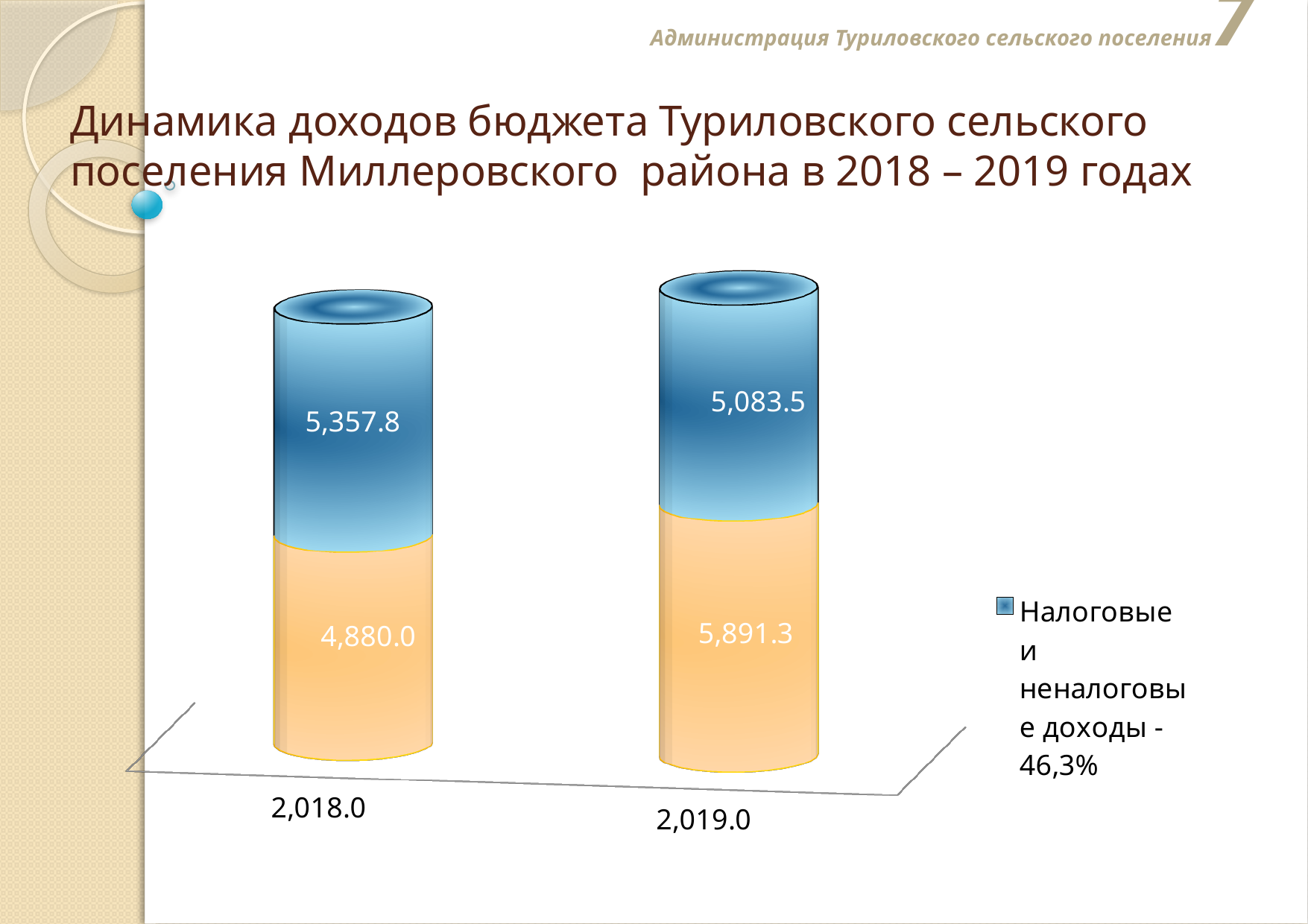
How many categories (years) are shown on the x axis of the chart? 2 What is the value of the lower orange segment of the bar for 2,019.0? 5,891.3 What is the total of the stacked bar for 2,019.0? 10,974.8 What type of chart is shown on the slide? Bar chart What is the total of the stacked bar for 2,018.0? 10,237.8 What is the value of the 'Налоговые и неналоговые доходы' (blue) segment for 2,018.0? 5,357.8 Does the blue 'Налоговые и неналоговые доходы' segment rise or fall from 2,018.0 to 2,019.0? Fall What is the value of the lower orange segment of the bar for 2,018.0? 4,880.0 What percentage is shown in the legend entry for 'Налоговые и неналоговые доходы'? 46,3% What is the value of the 'Налоговые и неналоговые доходы' (blue) segment for 2,019.0? 5,083.5 By how much does the blue 'Налоговые и неналоговые доходы' segment for 2,018.0 exceed that for 2,019.0? 274.3 Which year has the larger orange (lower) segment, 2,018.0 or 2,019.0? 2,019.0